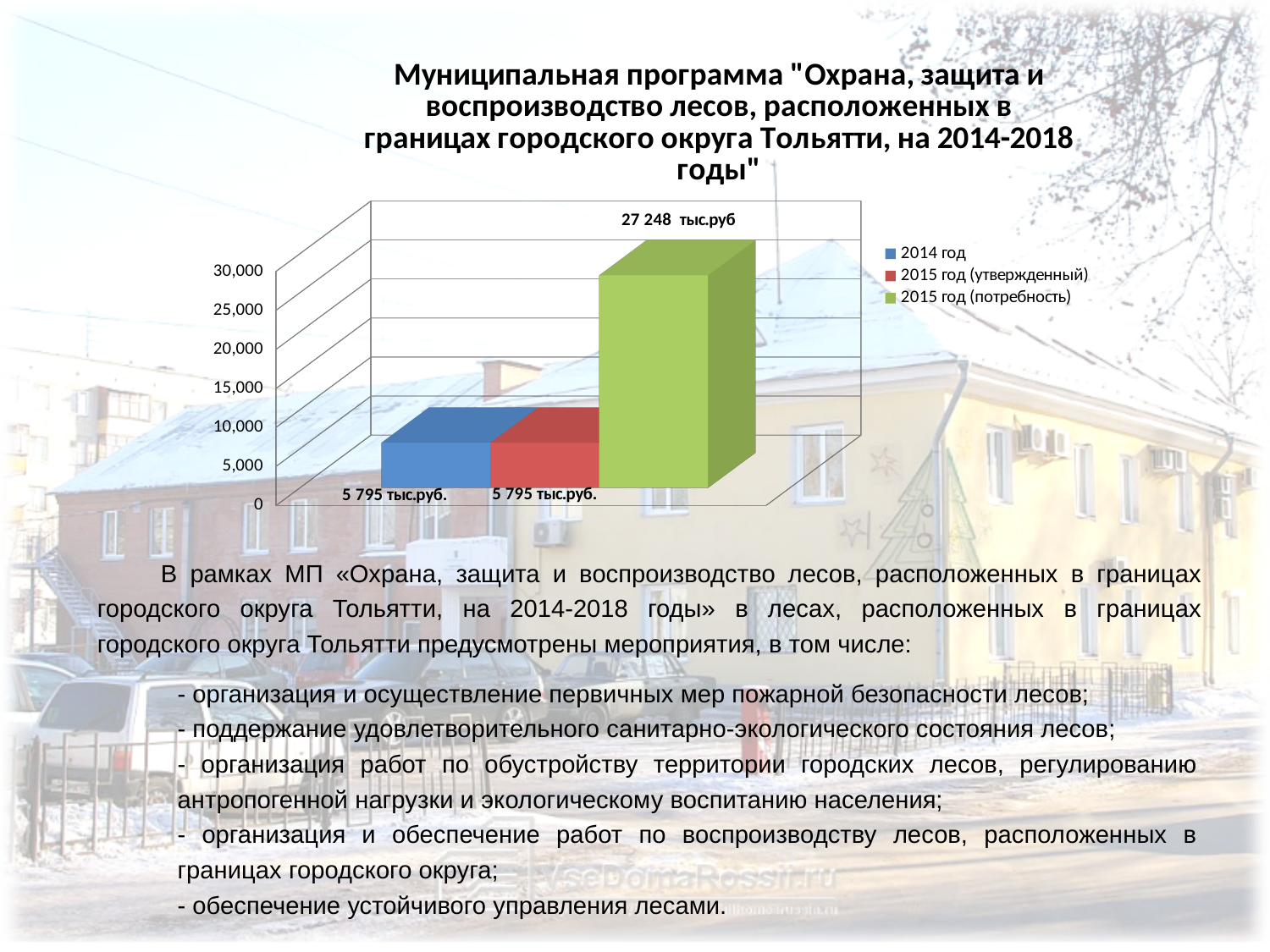
What colour is the bar for the series "2015 год (потребность)"? green Which series has the highest value? 2015 год (потребность) Is the value for "2014 год" greater or less than 10,000? less Which is larger: the value for "2015 год (потребность)" or the value for "2014 год"? 2015 год (потребность) What type of chart is shown on the slide? bar chart How many bars are plotted on the chart? 3 Is the value for "2015 год (потребность)" greater or less than 25,000? greater How many series does the chart legend list? 3 What is the value for the series "2014 год"? 5 795 тыс.руб. What is the value for the series "2015 год (потребность)"? 27 248 тыс.руб What is the value for the series "2015 год (утвержденный)"? 5 795 тыс.руб. What is the difference between the value for "2015 год (потребность)" and the value for "2015 год (утвержденный)"? 21 453 тыс.руб.